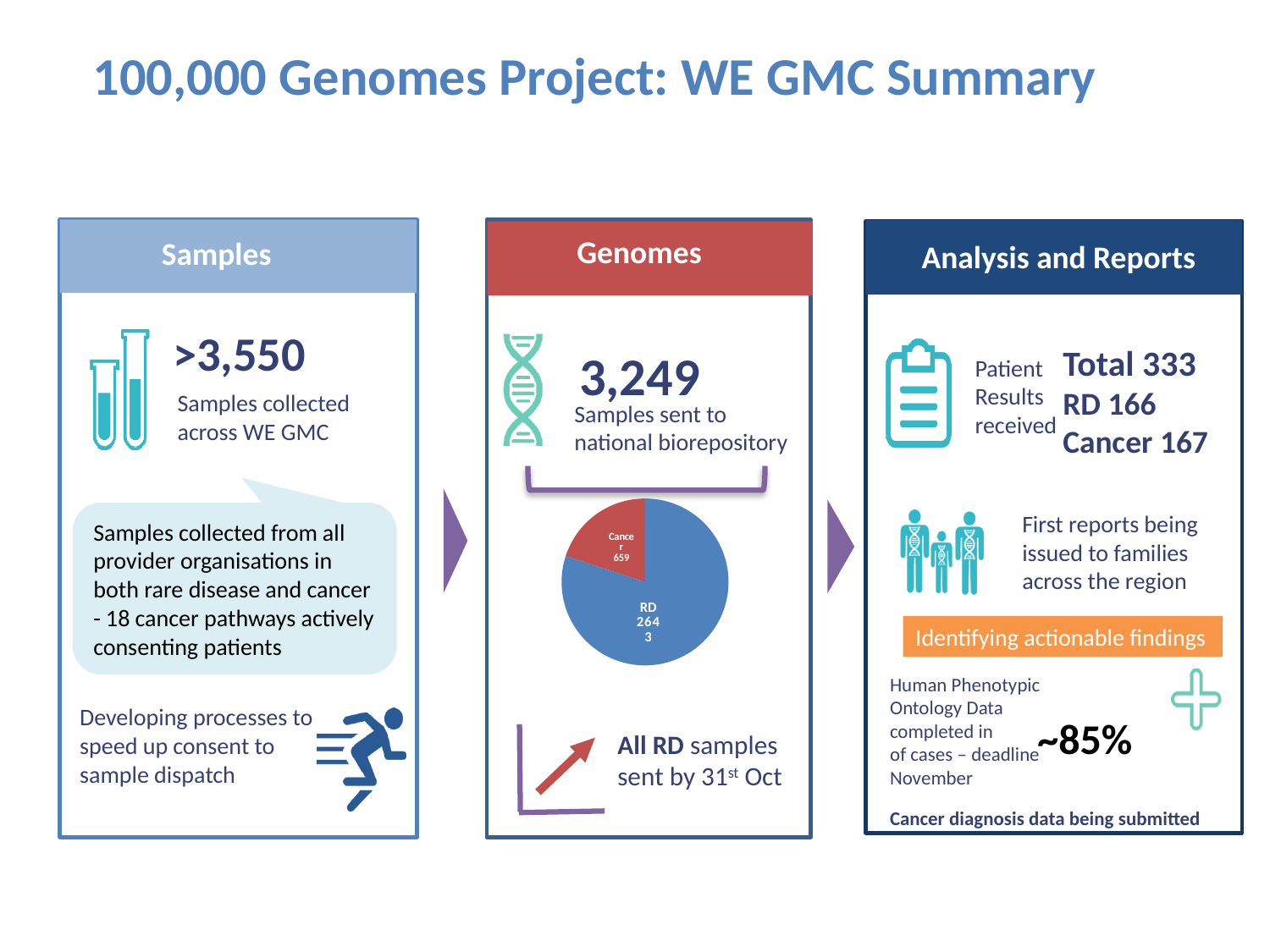
In the pie chart, what is the value for Cancer? 659 What is the difference between the RD and Cancer values in the pie chart? 1984 Which slice of the pie chart is the smallest? Cancer Under which panel heading does the pie chart appear? Genomes How many slices does the pie chart in the Genomes panel have? 2 What is the total of the two slices in the pie chart? 3302 In the pie chart, what is the value for RD? 2643 What kind of chart is shown in the Genomes panel? pie chart Which slice of the pie chart is the largest? RD In the pie chart, which is larger, RD or Cancer? RD What colour is the Cancer slice in the pie chart? red